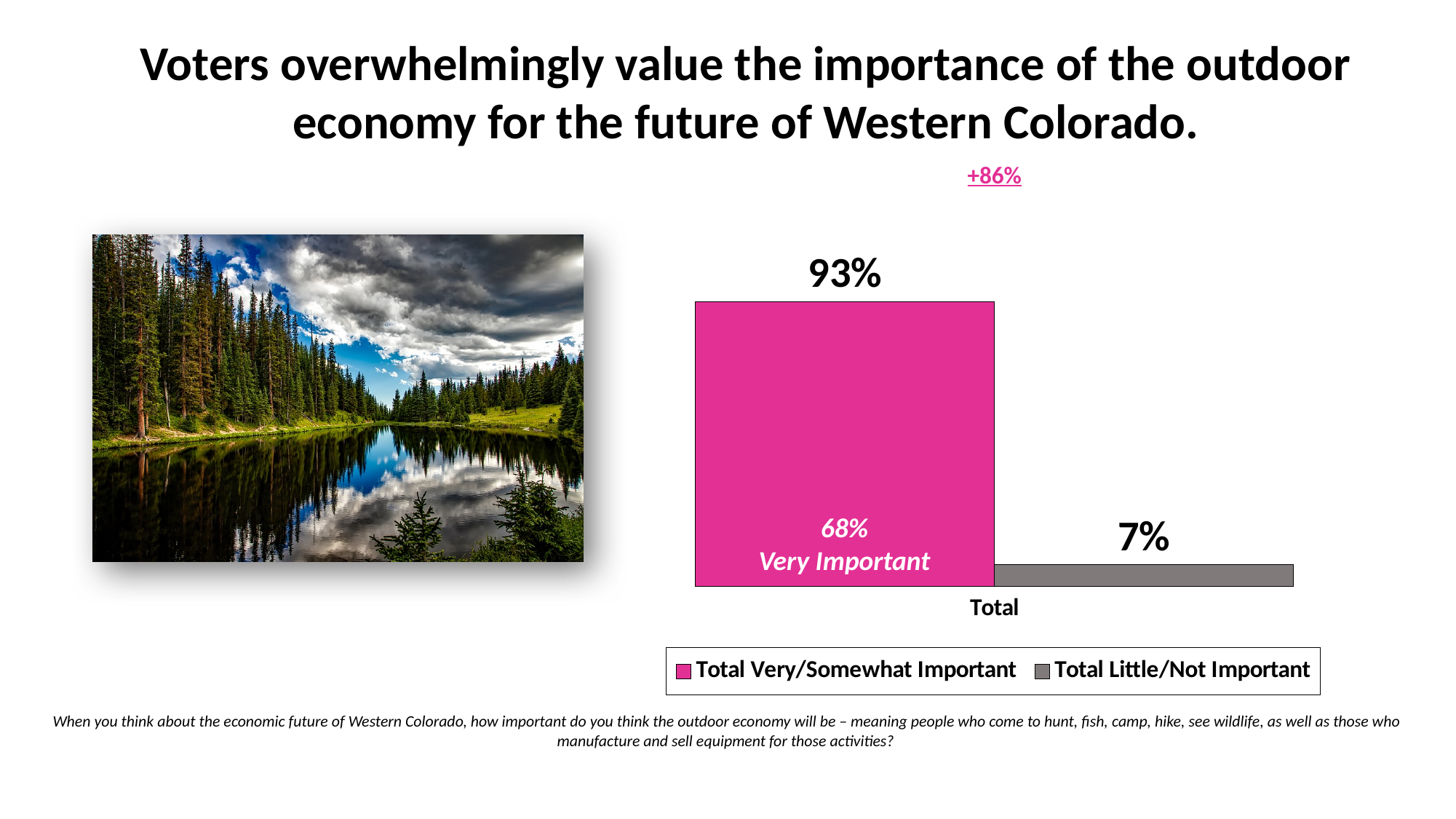
How many categories are shown on the x axis? 1 What is the value for Total Very/Somewhat Important? 93% What is the difference between Total Very/Somewhat Important and Total Little/Not Important? 86% What percentage of voters said the outdoor economy is Very Important? 68% What is the category label on the x axis of the chart? Total Which series has the higher value, Total Very/Somewhat Important or Total Little/Not Important? Total Very/Somewhat Important What is the value for Total Little/Not Important? 7% What colour is the bar for Total Little/Not Important? Grey What kind of chart is shown on the slide? Bar chart How many series does the legend list? 2 What net difference is printed above the chart? +86%